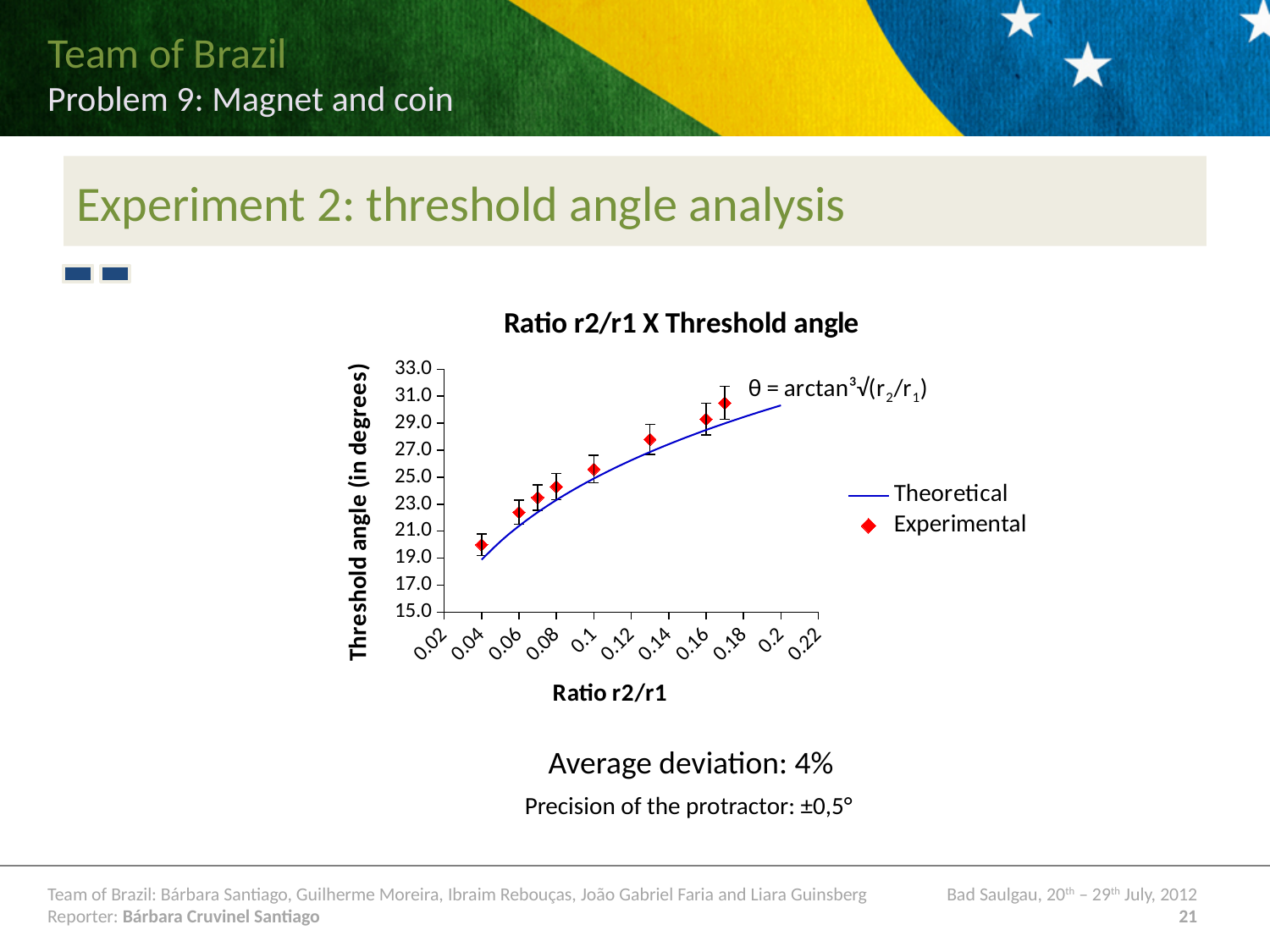
Is the experimental threshold angle at the lowest ratio (about 0.04) greater or less than 21.0 degrees? less How many series does the legend list? 2 Which experimental point has the highest threshold angle: the one at the lowest ratio or the one at the highest ratio? The one at the highest ratio What is the title of the chart? Ratio r2/r1 X Threshold angle What are the two series named in the legend? Theoretical and Experimental Does the threshold angle rise or fall as the ratio r2/r1 increases? Rises Is the experimental threshold angle at a ratio of about 0.1 greater or less than 27.0 degrees? less What kind of chart is shown on the slide? Scatter chart with a fitted line At which ratio r2/r1 is the experimental threshold angle lowest? 0.04 Is the experimental threshold angle at the highest ratio (about 0.17) greater or less than 29.0 degrees? greater How many experimental data points are plotted? 8